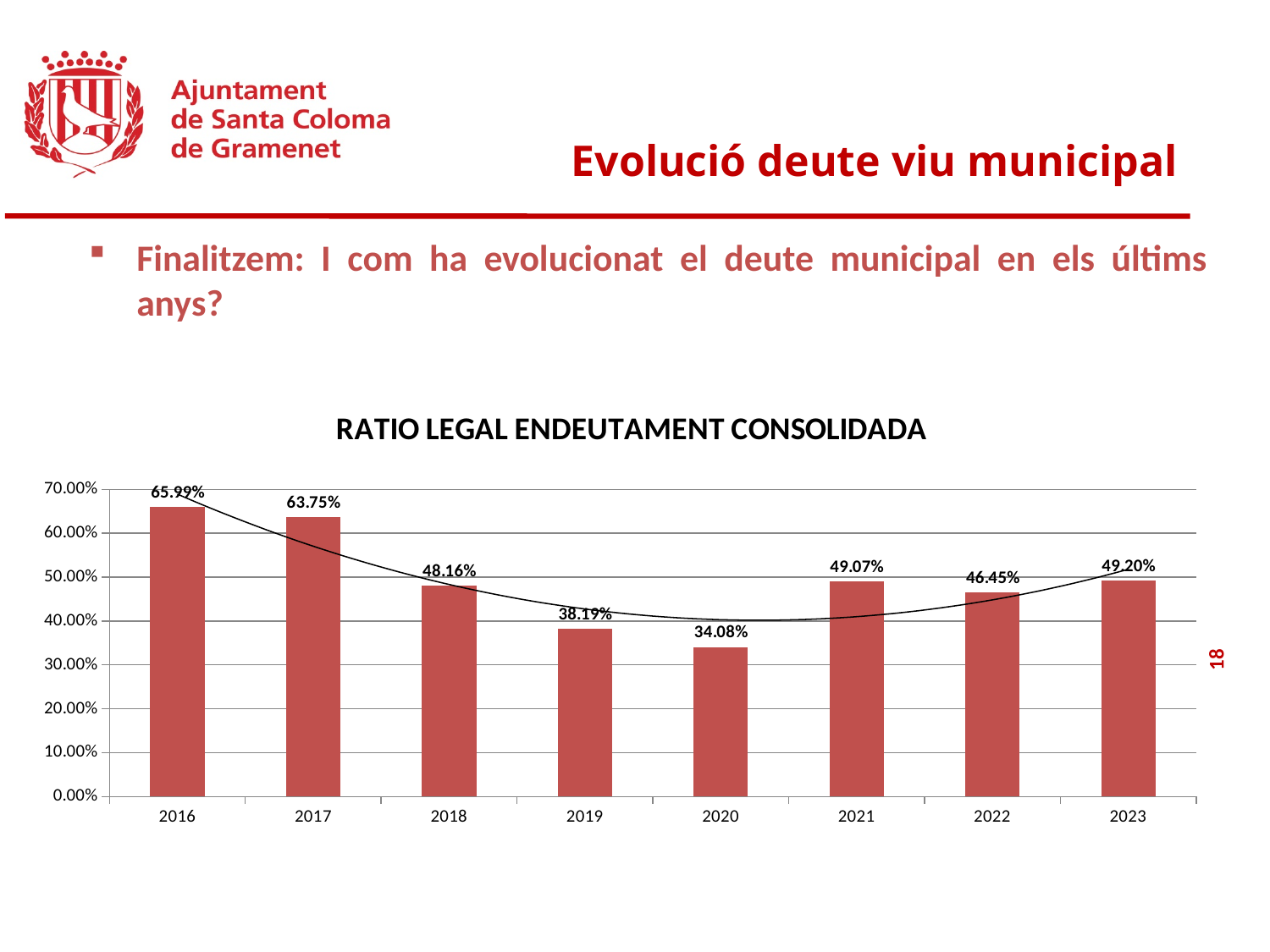
Which is larger, the value for 2018 or the value for 2019? 2018 What is the value for 2023? 49.20% What is the value for 2016? 65.99% What is the difference between the values for 2021 and 2022? 2.62% What is the value for 2020? 34.08% What is the difference between the values for 2016 and 2017? 2.24% What is the title of the chart? RATIO LEGAL ENDEUTAMENT CONSOLIDADA Is the value for 2022 greater or less than 40.00%? greater Which year has the highest value? 2016 Which year has the lowest value? 2020 How many years are shown on the x axis? 8 What kind of chart is this? Bar chart